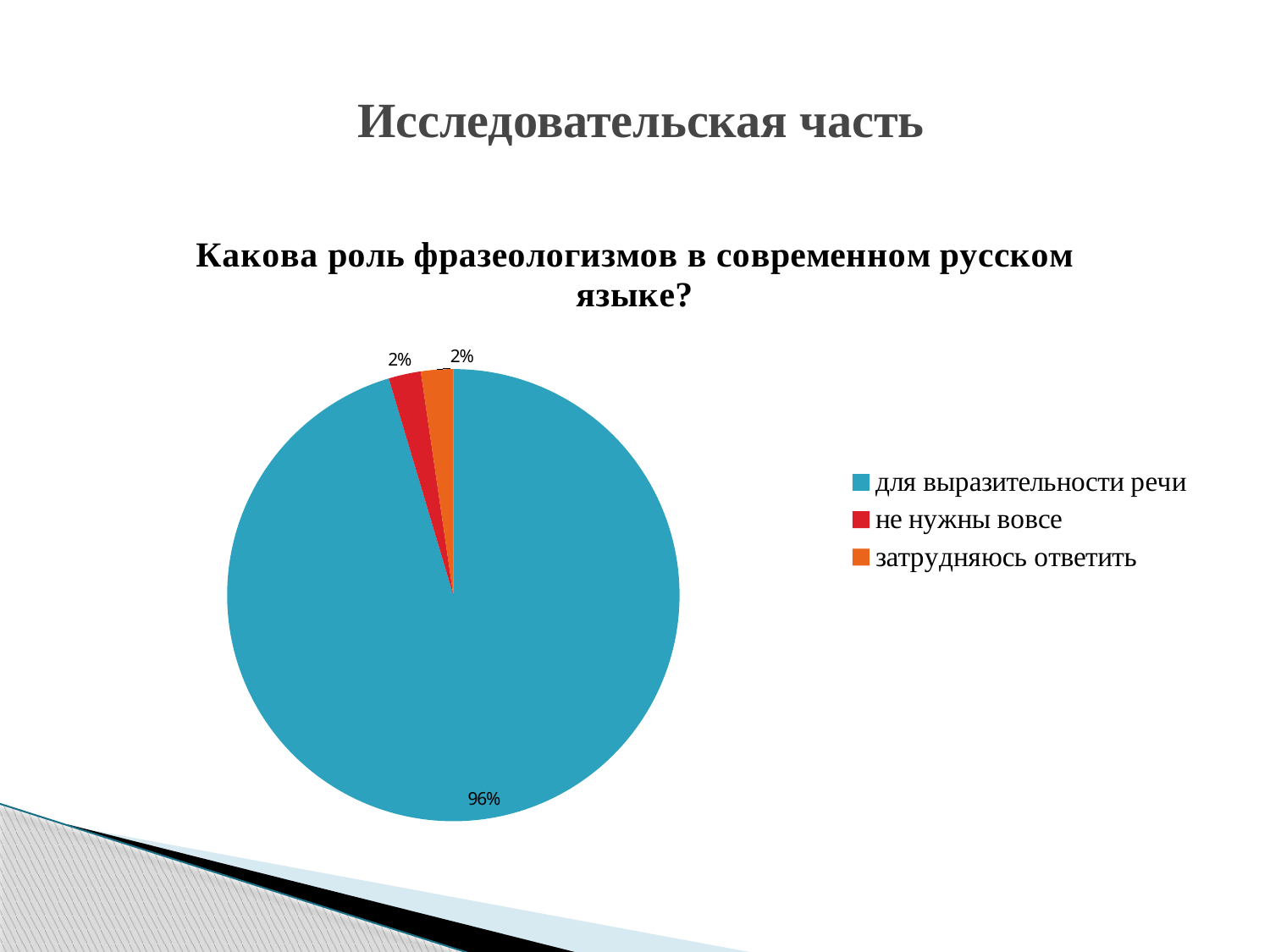
What is the title of the chart? Какова роль фразеологизмов в современном русском языке? What share of the pie is labelled "для выразительности речи"? 96% How many slices does the pie chart have? 3 Which is larger: the slice for "для выразительности речи" or the slice for "затрудняюсь ответить"? для выразительности речи Is the share for "для выразительности речи" greater or less than 50%? greater How many entries does the legend list? 3 What kind of chart is shown on the slide? pie chart What share of the pie is labelled "затрудняюсь ответить"? 2% What share of the pie is labelled "не нужны вовсе"? 2% What is the difference in percentage points between "для выразительности речи" and "не нужны вовсе"? 94% Which category has the largest slice of the pie? для выразительности речи What colour is the slice for "не нужны вовсе"? red